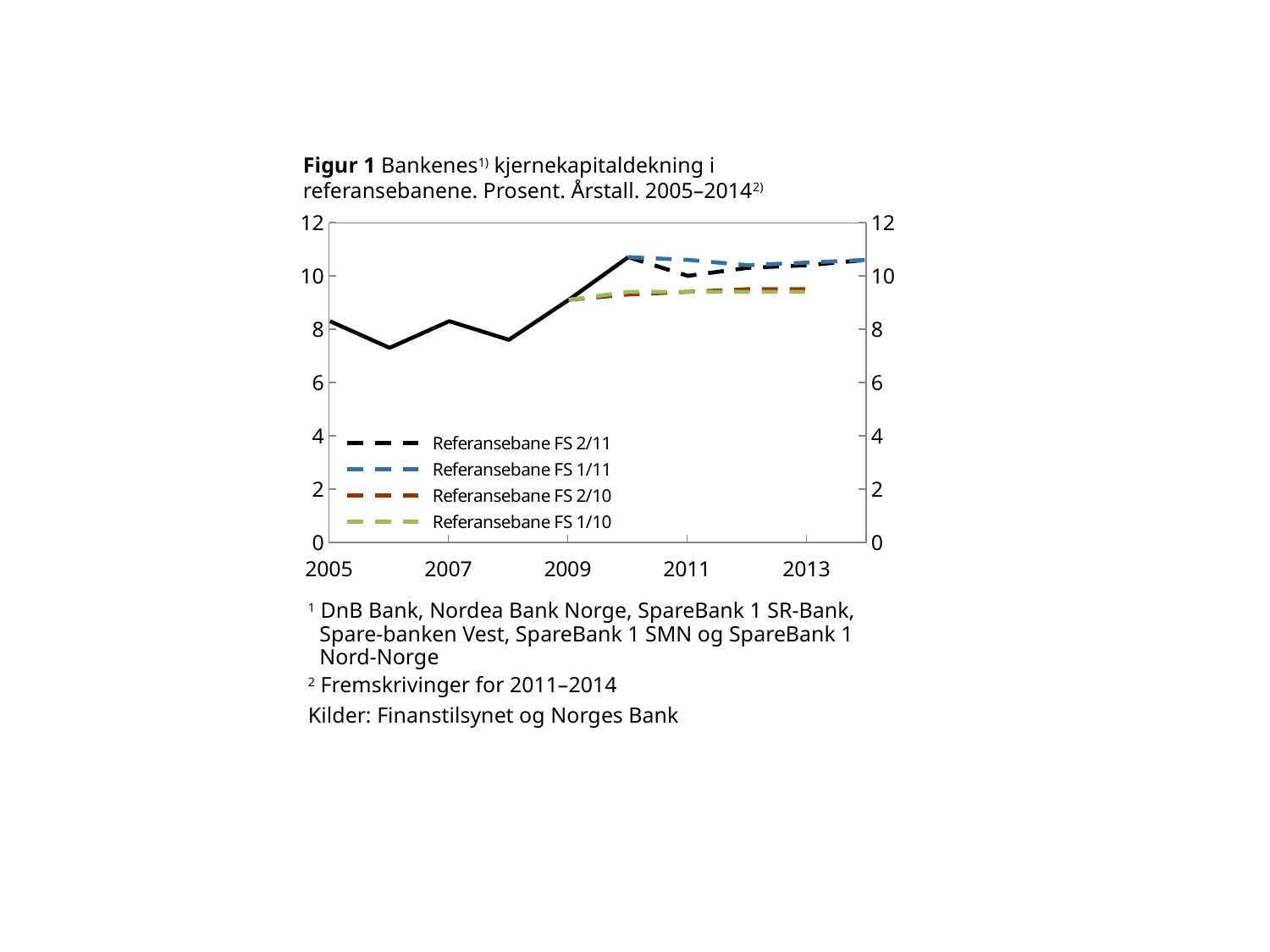
Is the value for 2010 greater or less than 10? greater What kind of chart is shown on the slide? line chart Which year has the higher value: 2006 or 2010? 2010 Is the value for 2008 greater or less than 8? less Is the value for 2006 greater or less than 8? less Which series is drawn with a blue dashed line? Referansebane FS 1/11 What is the figure number given in the chart title? Figur 1 How many series does the legend list? 4 Which is larger in 2013: Referansebane FS 1/11 or Referansebane FS 2/10? Referansebane FS 1/11 Does the line rise or fall from 2008 to 2010? rise